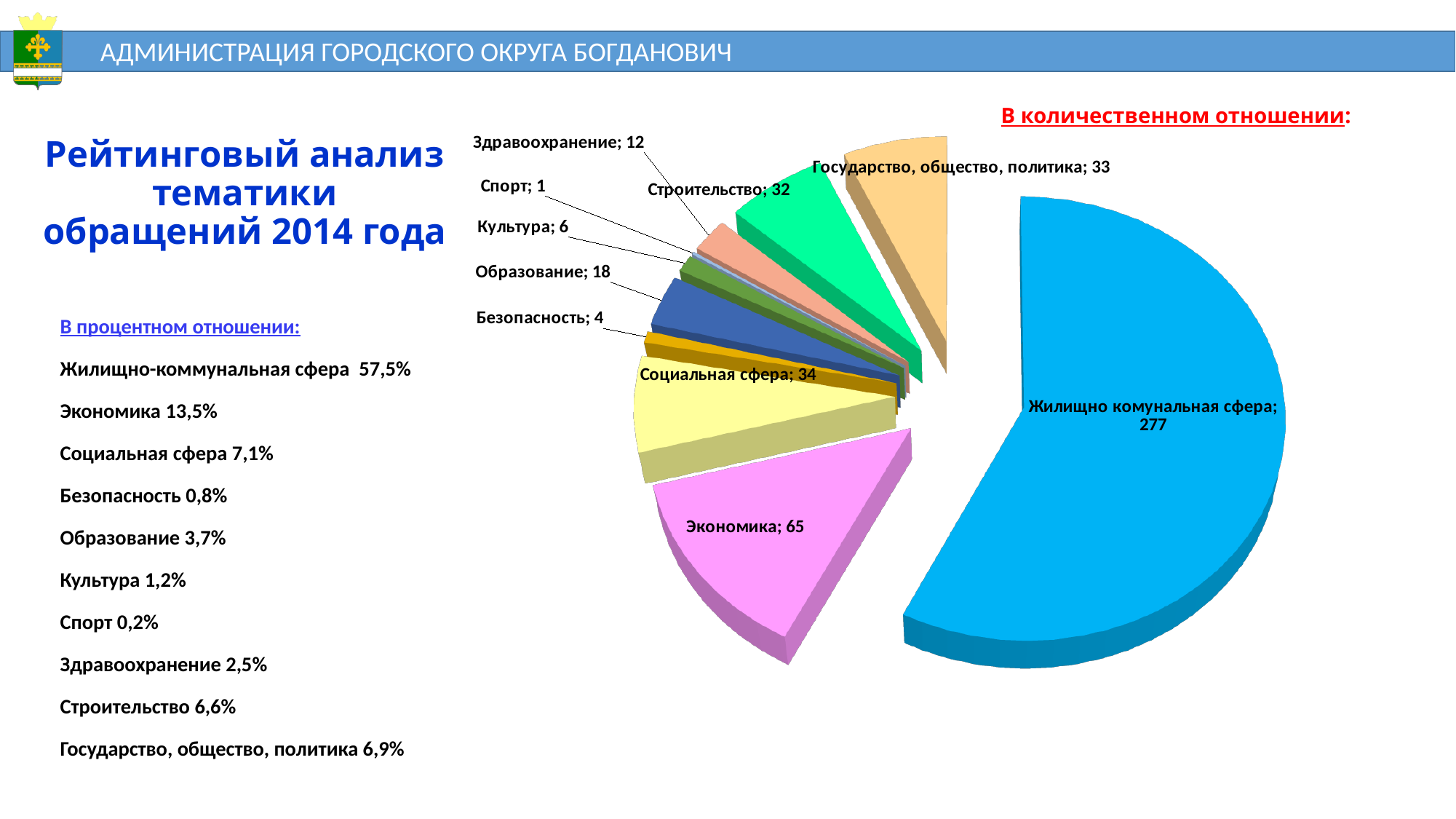
Which category has the largest slice in the pie chart? Жилищно комунальная сфера What is the difference between the values for Образование and Безопасность? 14 What type of chart is shown on the slide? pie chart What is the value for Жилищно комунальная сфера in the pie chart? 277 According to the slide, what share of the total does Жилищно-коммунальная сфера represent? 57,5% Which is larger in the pie chart: Строительство or Здравоохранение? Строительство Which category has the smallest slice in the pie chart? Спорт What is the difference between the values for Экономика and Социальная сфера? 31 What is the value for Государство, общество, политика in the pie chart? 33 What is the value for Спорт in the pie chart? 1 How many categories (slices) does the pie chart have? 10 What is the value for Экономика in the pie chart? 65